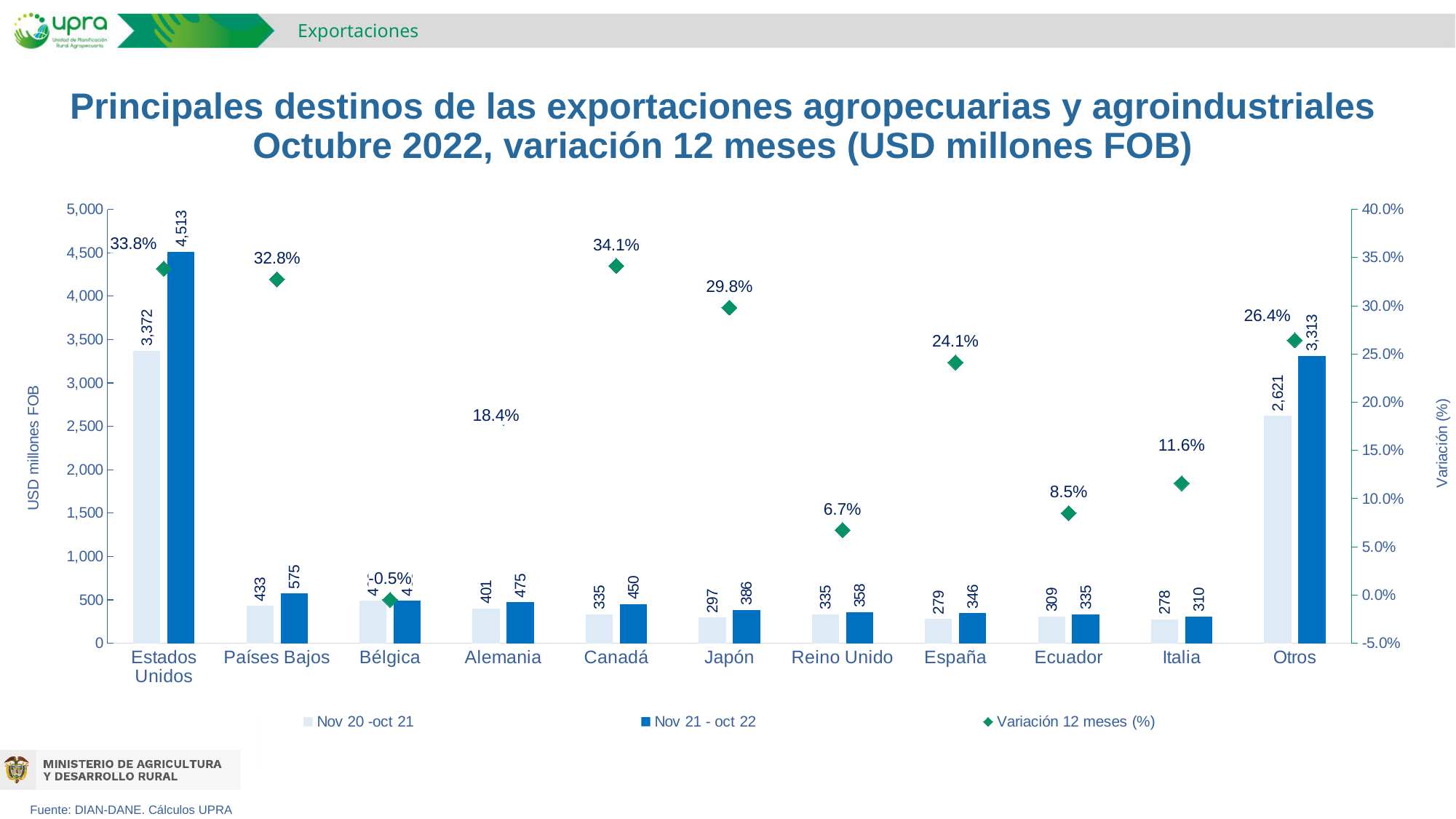
What is the value for Estados Unidos in the Nov 21 - oct 22 series? 4,513 What is the difference between the Nov 21 - oct 22 and Nov 20 - oct 21 values for Estados Unidos? 1,141 Is the Nov 21 - oct 22 value for Otros greater or less than 3,000? greater What is the label of the left vertical axis? USD millones FOB What is the Variación 12 meses (%) for Canadá? 34.1% How many series does the legend list? 3 Which destination has the highest Variación 12 meses (%)? Canadá What is the value for Otros in the Nov 20 - oct 21 series? 2,621 Which destination has the lowest Variación 12 meses (%)? Bélgica What is the Nov 21 - oct 22 value for Japón? 386 How many destination categories are shown on the x axis? 11 Which is larger for Alemania: the Nov 20 - oct 21 value or the Nov 21 - oct 22 value? Nov 21 - oct 22